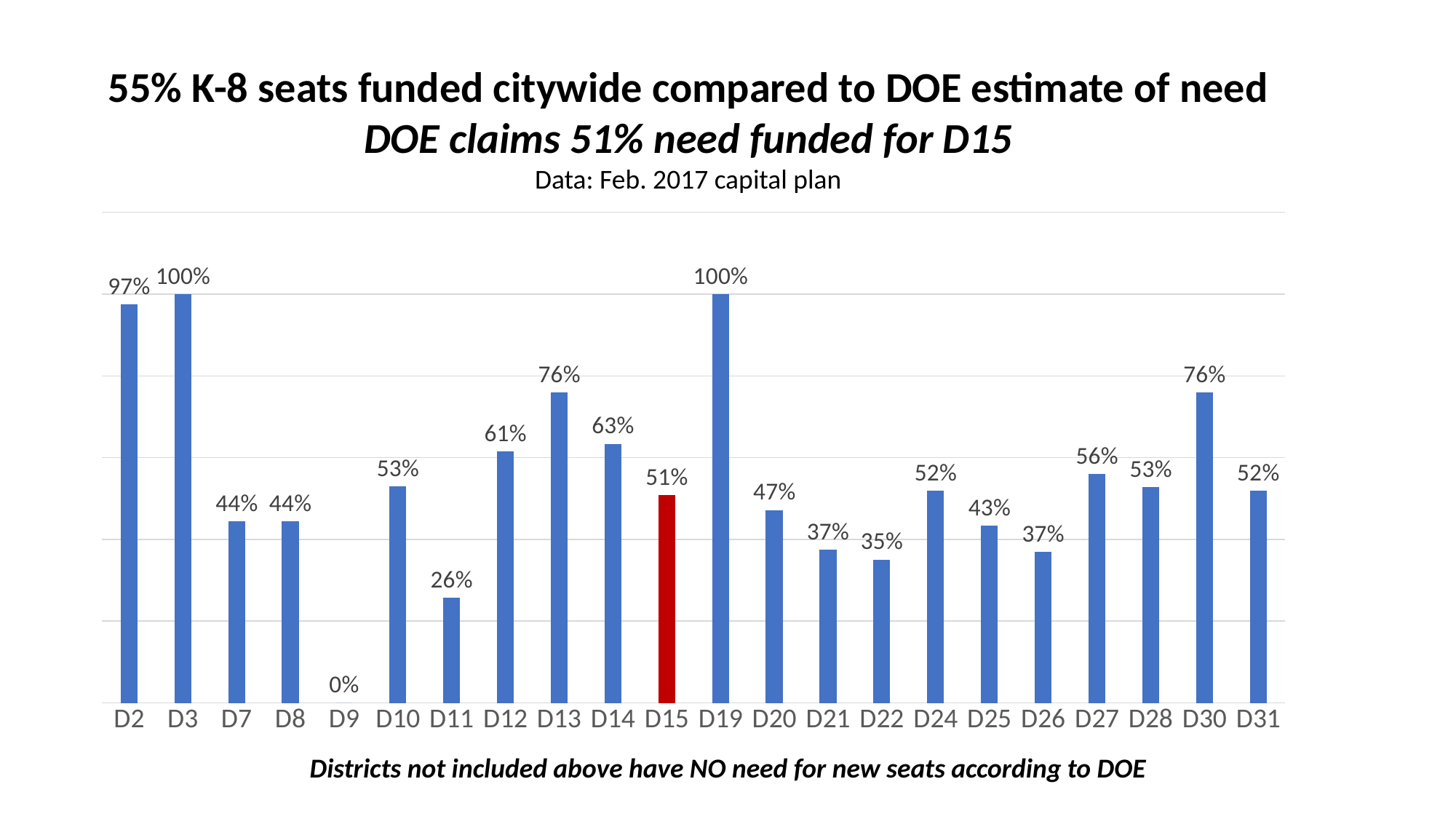
What is the difference between the values for D13 and D15? 25% Which district has the lowest value? D9 How many districts are shown on the x axis? 22 What is the difference between the values for D2 and D22? 62% What is the value for D15? 51% Which is larger, the value for D27 or the value for D25? D27 What is the value for D11? 26% Which is larger, the value for D12 or the value for D20? D12 What kind of chart is shown on the slide? Bar chart Which districts share the highest value of 100%? D3 and D19 Which district's bar is coloured red instead of blue? D15 What is the value for D30? 76%